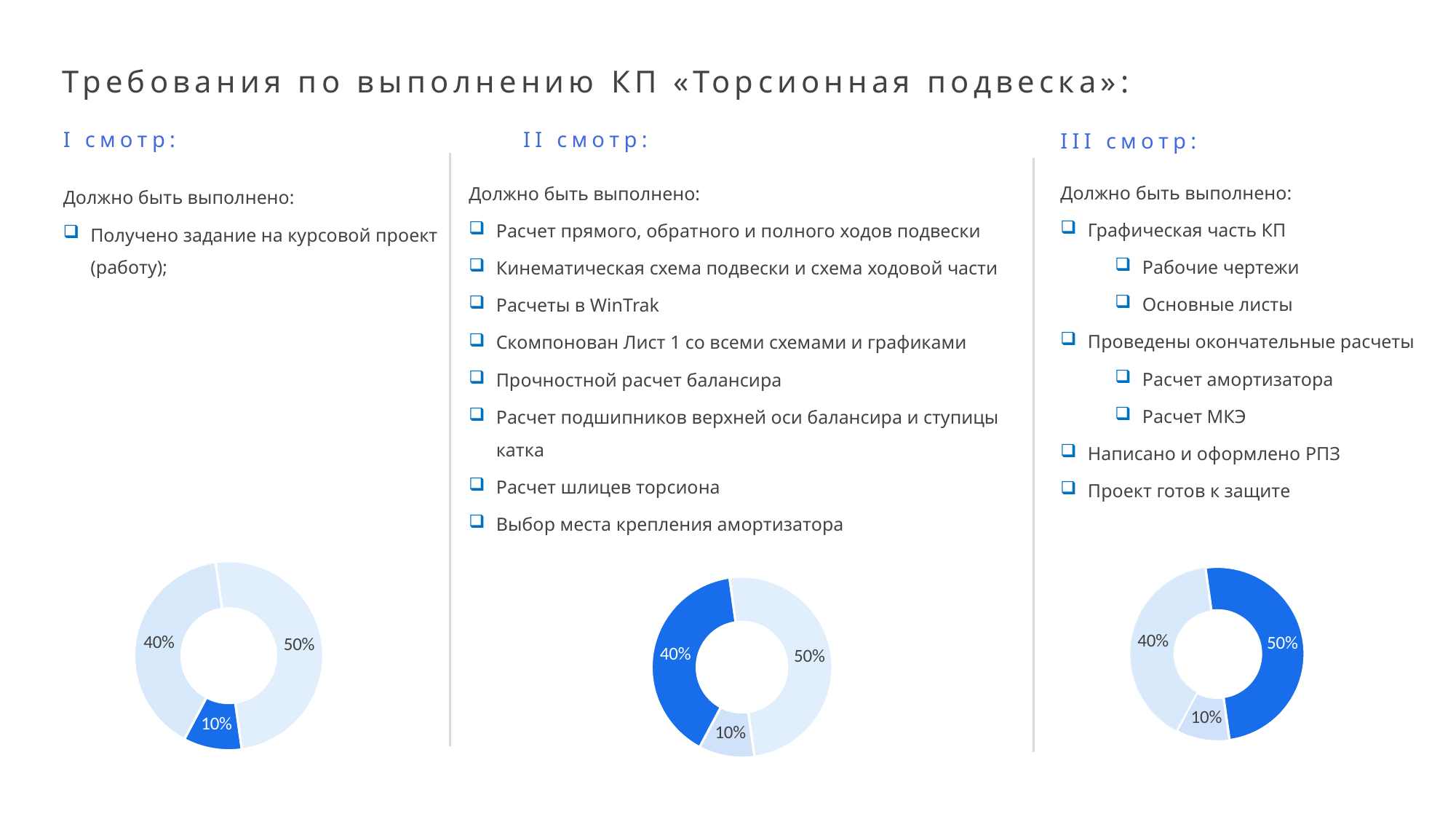
In the doughnut chart under "II смотр", what is the value of the dark blue highlighted slice? 40% What type of chart is shown under the "I смотр" column? Doughnut chart How many slices does the doughnut chart under "II смотр" have? 3 In the doughnut chart under "III смотр", what is the smallest slice's value? 10% In the doughnut chart under "I смотр", what is the value of the dark blue highlighted slice? 10% In the doughnut chart under "III смотр", what is the value of the dark blue highlighted slice? 50% In the doughnut chart under "I смотр", what is the largest slice's value? 50% How many doughnut charts are on the slide? 3 In the doughnut chart under "III смотр", which is larger: the highlighted slice or the 40% slice? The highlighted slice (50%) In the doughnut chart under "II смотр", what is the difference between the largest and smallest slices? 40% What do the three slice values in the doughnut chart under "I смотр" add up to? 100% In the doughnut chart under "I смотр", what is the difference between the 50% slice and the 40% slice? 10%